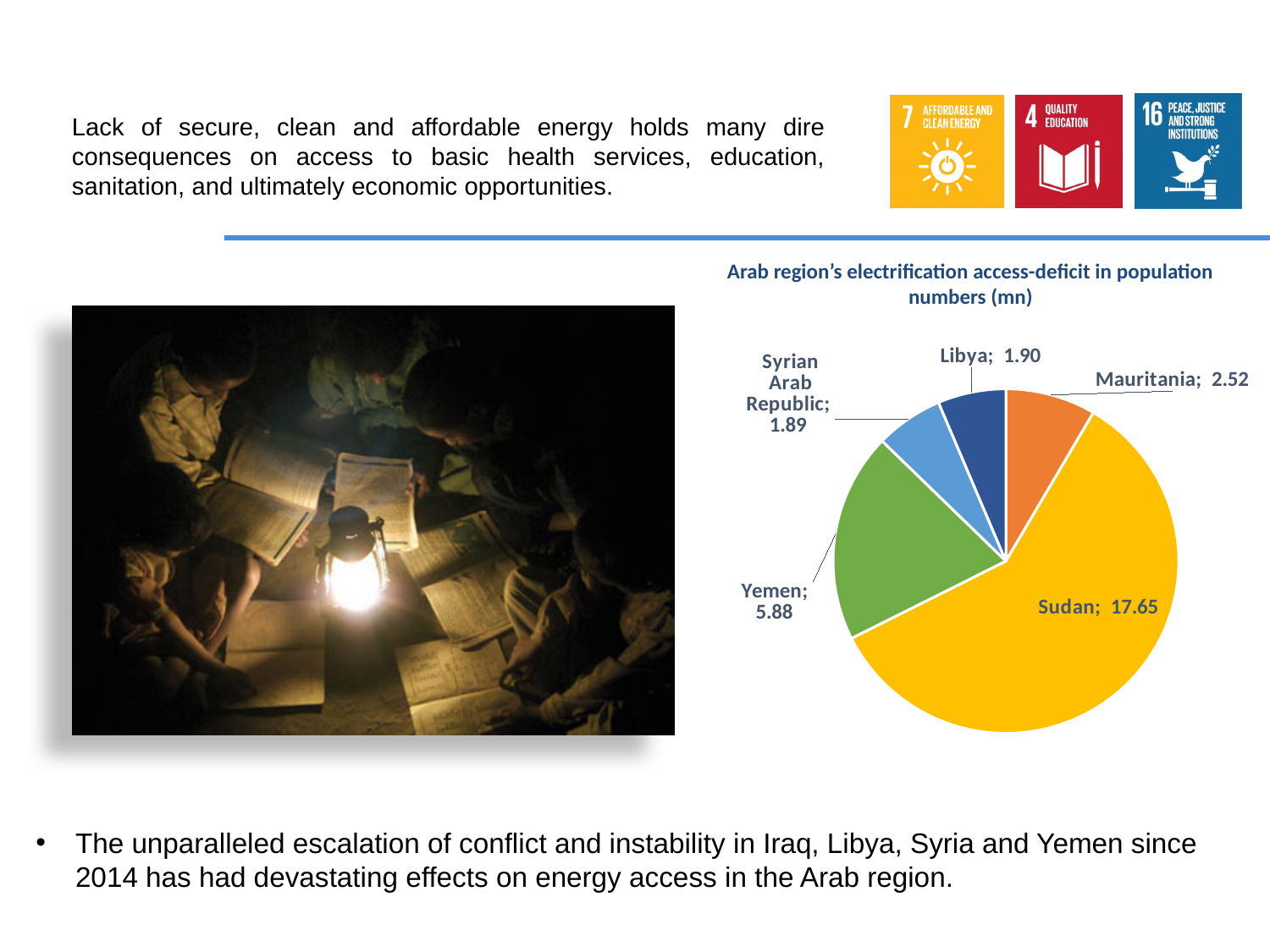
What is the title of the chart? Arab region's electrification access-deficit in population numbers (mn) What colour is the slice for Sudan? yellow What is the value for Yemen in the pie chart? 5.88 What type of chart is shown on the slide? pie chart What is the value for Sudan in the pie chart? 17.65 Which has a larger value, Yemen or Mauritania? Yemen What is the value for Mauritania in the pie chart? 2.52 What is the value for the Syrian Arab Republic in the pie chart? 1.89 What is the difference between the values for Sudan and Yemen? 11.77 How many countries are shown in the pie chart? 5 Which country has the largest slice of the pie chart? Sudan Which country has the smallest value in the pie chart? Syrian Arab Republic